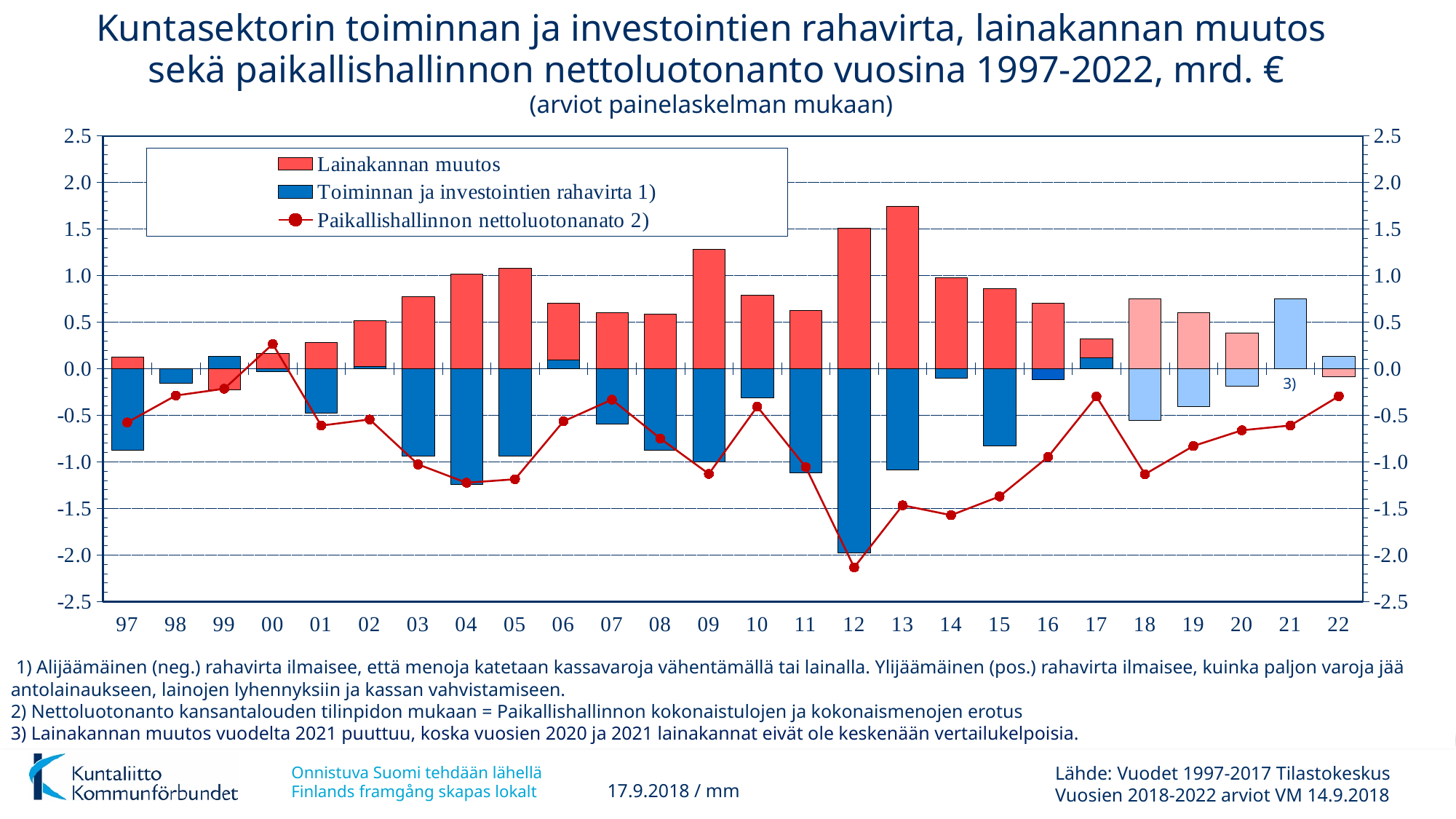
In which year is the Toiminnan ja investointien rahavirta bar the lowest? 12 In which year is the Lainakannan muutos bar the highest? 13 Which is larger, the Lainakannan muutos bar for 13 or for 14? 13 What kind of chart is shown on the slide? A bar chart combined with a line Is the Paikallishallinnon nettoluotonanto value for 00 greater or less than 0.0? greater Does the Paikallishallinnon nettoluotonanto line rise or fall from 18 to 22? rise Is the Toiminnan ja investointien rahavirta value for 12 greater or less than -1.5? less How many series does the legend list? 3 How many years are shown on the x axis? 26 In which year does the Paikallishallinnon nettoluotonanto line reach its lowest point? 12 Is the Lainakannan muutos value for 13 greater or less than 1.5? greater In which year is the Toiminnan ja investointien rahavirta bar the highest? 21